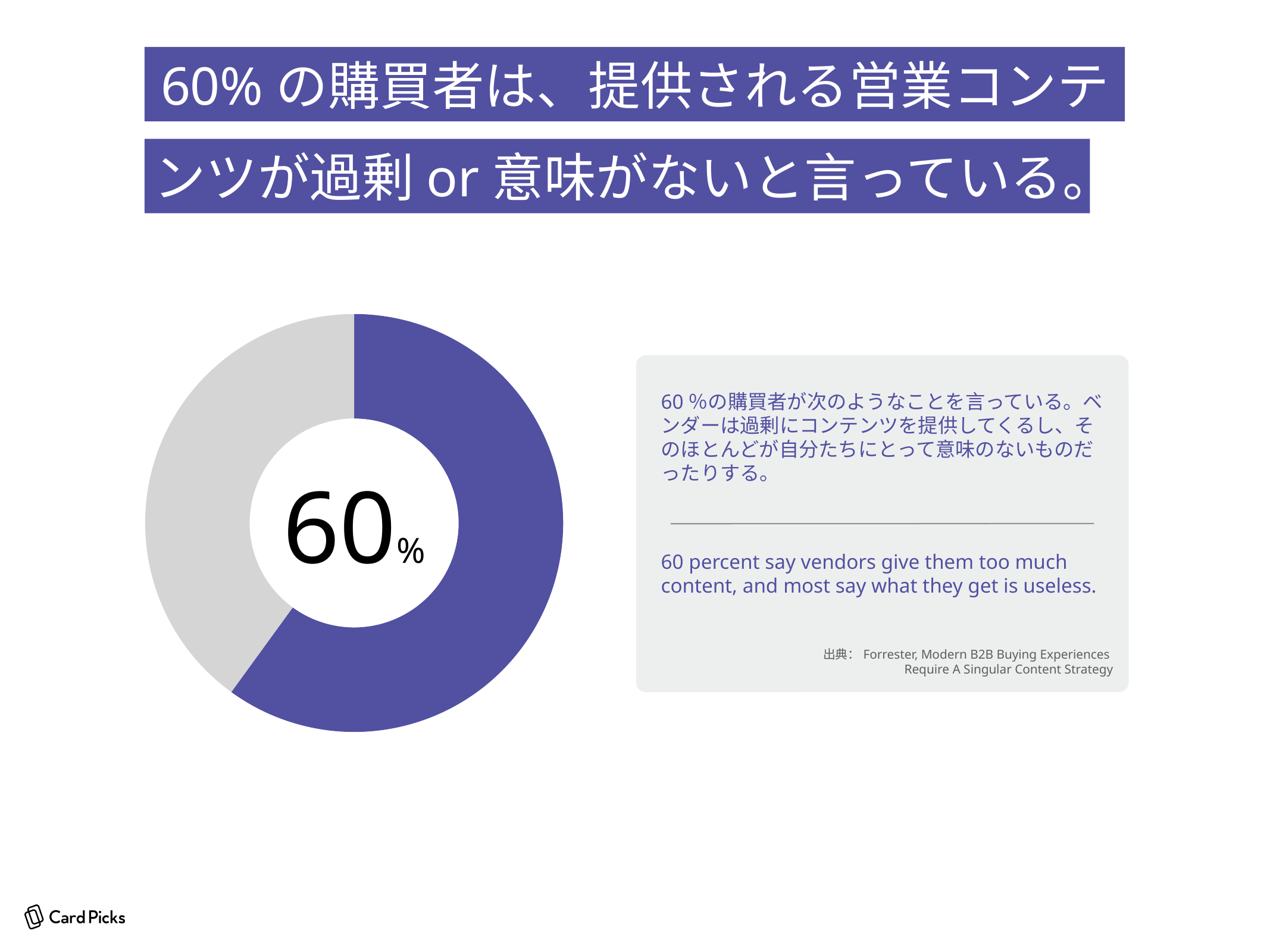
How many slices does the donut chart have? 2 What colour is the slice representing the 60% value in the donut chart? Purple What share of the donut chart does the purple slice represent? 60% What share of the donut chart does the grey slice represent? 40% Does the donut chart have a legend? No What kind of chart is shown on the slide? Donut (pie) chart Is the grey slice of the donut chart greater or less than 50% of the whole? less Is the purple slice of the donut chart greater or less than 50% of the whole? greater Which slice of the donut chart is larger, the purple one or the grey one? The purple one What percentage is printed in the centre of the donut chart? 60%